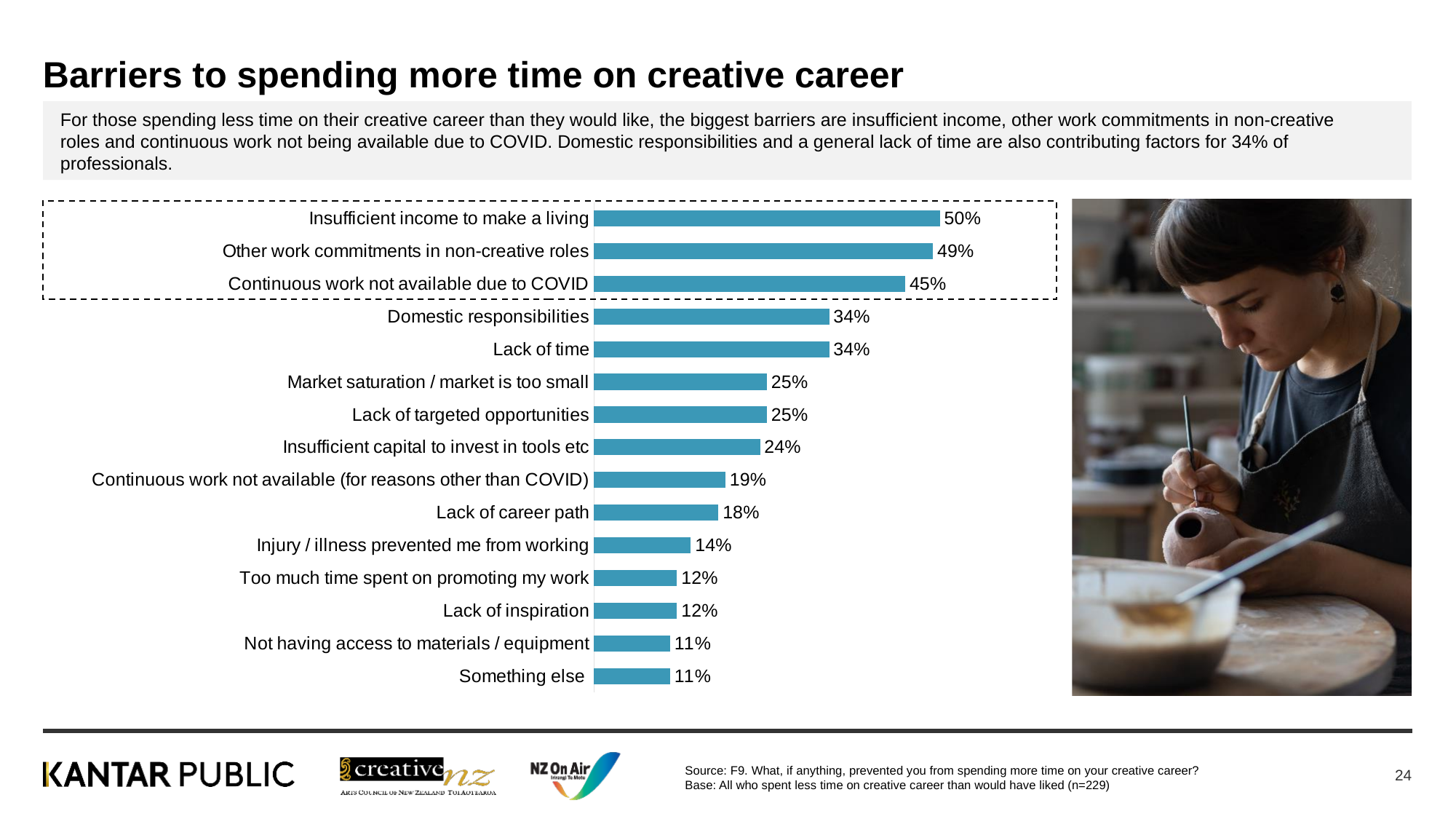
Which is larger: 'Other work commitments in non-creative roles' or 'Lack of time'? Other work commitments in non-creative roles What kind of chart is shown on the slide? Bar chart What percentage cited 'Lack of career path'? 18% What is the value for 'Continuous work not available due to COVID'? 45% What is the difference between 'Domestic responsibilities' and 'Injury / illness prevented me from working'? 20% Which barrier has the highest percentage? Insufficient income to make a living What is the difference between 'Insufficient income to make a living' and 'Continuous work not available due to COVID'? 5% Which is larger: 'Market saturation / market is too small' or 'Lack of career path'? Market saturation / market is too small How many of the top categories are enclosed by the dashed box on the chart? 3 How many barrier categories are shown in the chart? 15 What percentage of respondents cited insufficient income to make a living as a barrier? 50% What is the value for 'Insufficient capital to invest in tools etc'? 24%